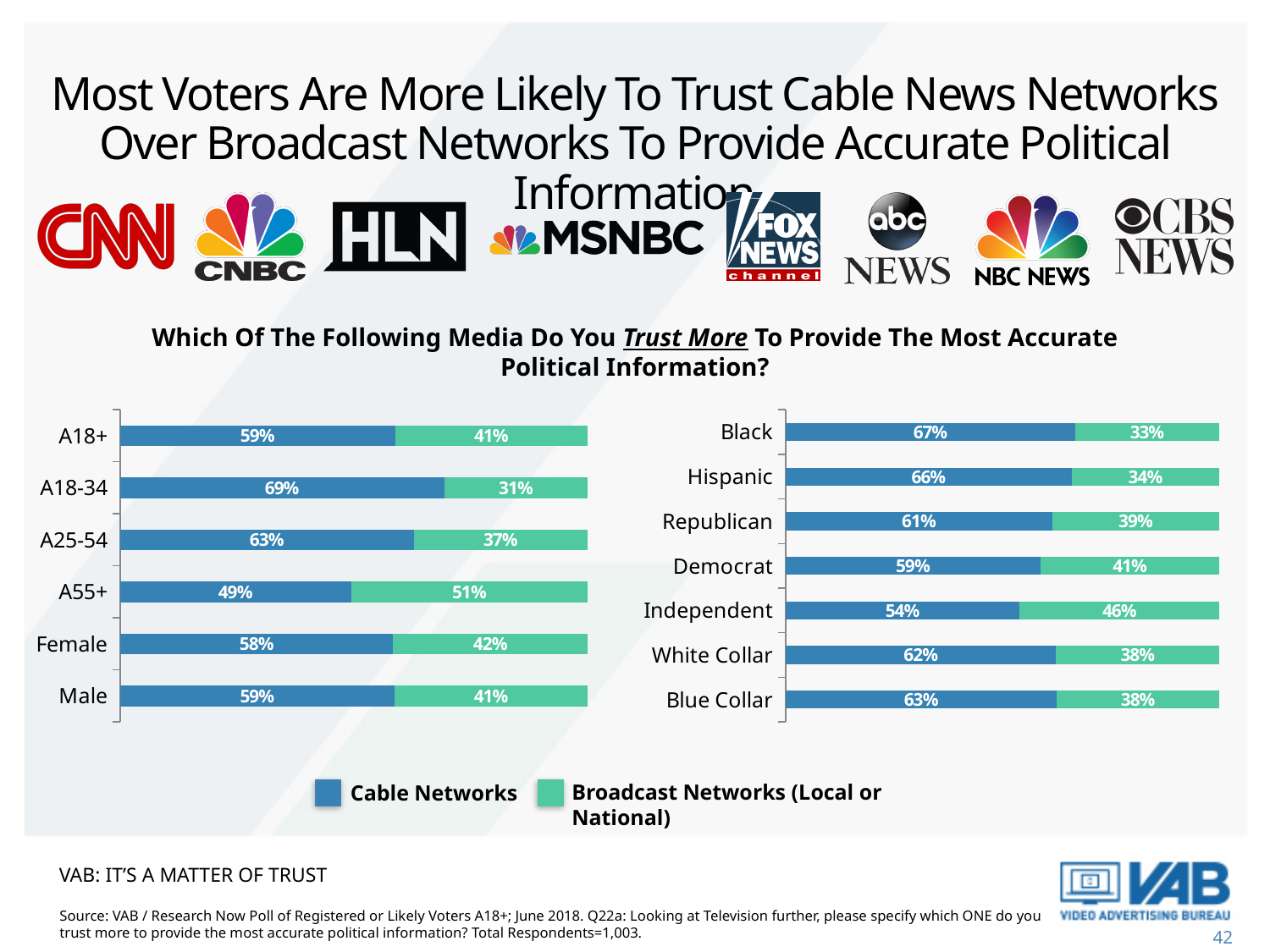
In the right chart, which category has the lowest Cable Networks value? Independent In the left chart, what is the difference between the Cable Networks values for A18-34 and A55+? 20 percentage points In the left chart, which category is the only one where Broadcast Networks exceeds Cable Networks? A55+ In the right chart, which is larger: the Cable Networks value for Black voters or for Democrat voters? Black In the left chart, what percentage of A18-34 voters trust Cable Networks more? 69% What type of chart is the left chart? Stacked bar chart In the right chart, what is the Cable Networks value for Independent voters? 54% In the left chart, what is the Broadcast Networks value for A55+? 51% In the left chart, which category has the highest Cable Networks value? A18-34 In the right chart, what is the Broadcast Networks value for Hispanic voters? 34% How many categories are shown in the right chart? 7 How many series does the legend list? 2